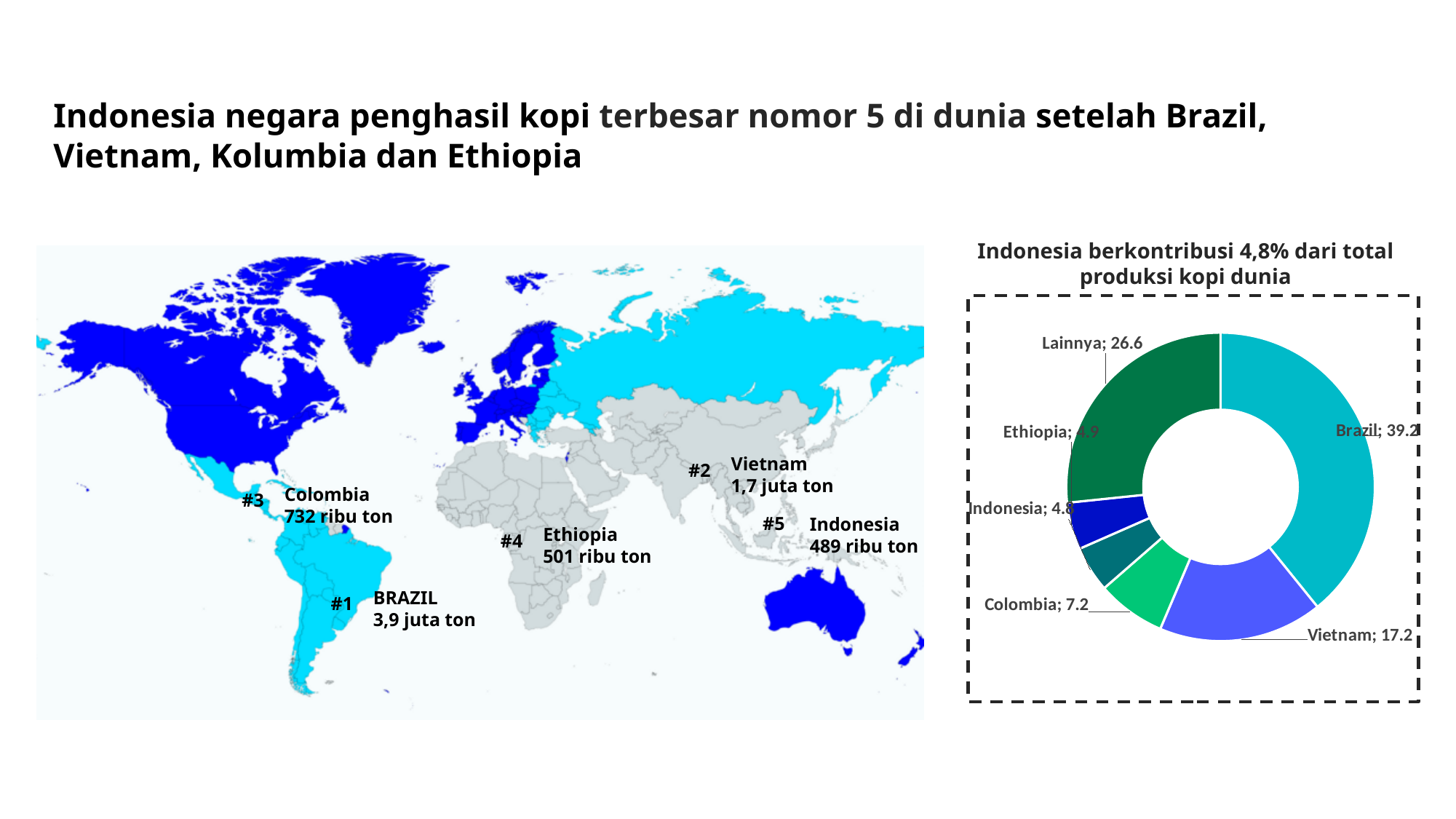
What is the title of the doughnut chart? Indonesia berkontribusi 4,8% dari total produksi kopi dunia What is the difference between the values for Brazil and Vietnam in the doughnut chart? 22.0 In the doughnut chart, what value is shown for Indonesia? 4.8 In the doughnut chart, what value is shown for Brazil? 39.2 In the doughnut chart, which is larger: Vietnam or Lainnya? Lainnya What type of chart is shown on the right side of the slide? Doughnut chart How many categories are shown in the doughnut chart? 6 In the doughnut chart, what value is shown for Colombia? 7.2 Which category has the largest slice in the doughnut chart? Brazil In the doughnut chart, what value is shown for Vietnam? 17.2 In the doughnut chart, what value is shown for Lainnya? 26.6 What is the difference between the values for Colombia and Indonesia in the doughnut chart? 2.4